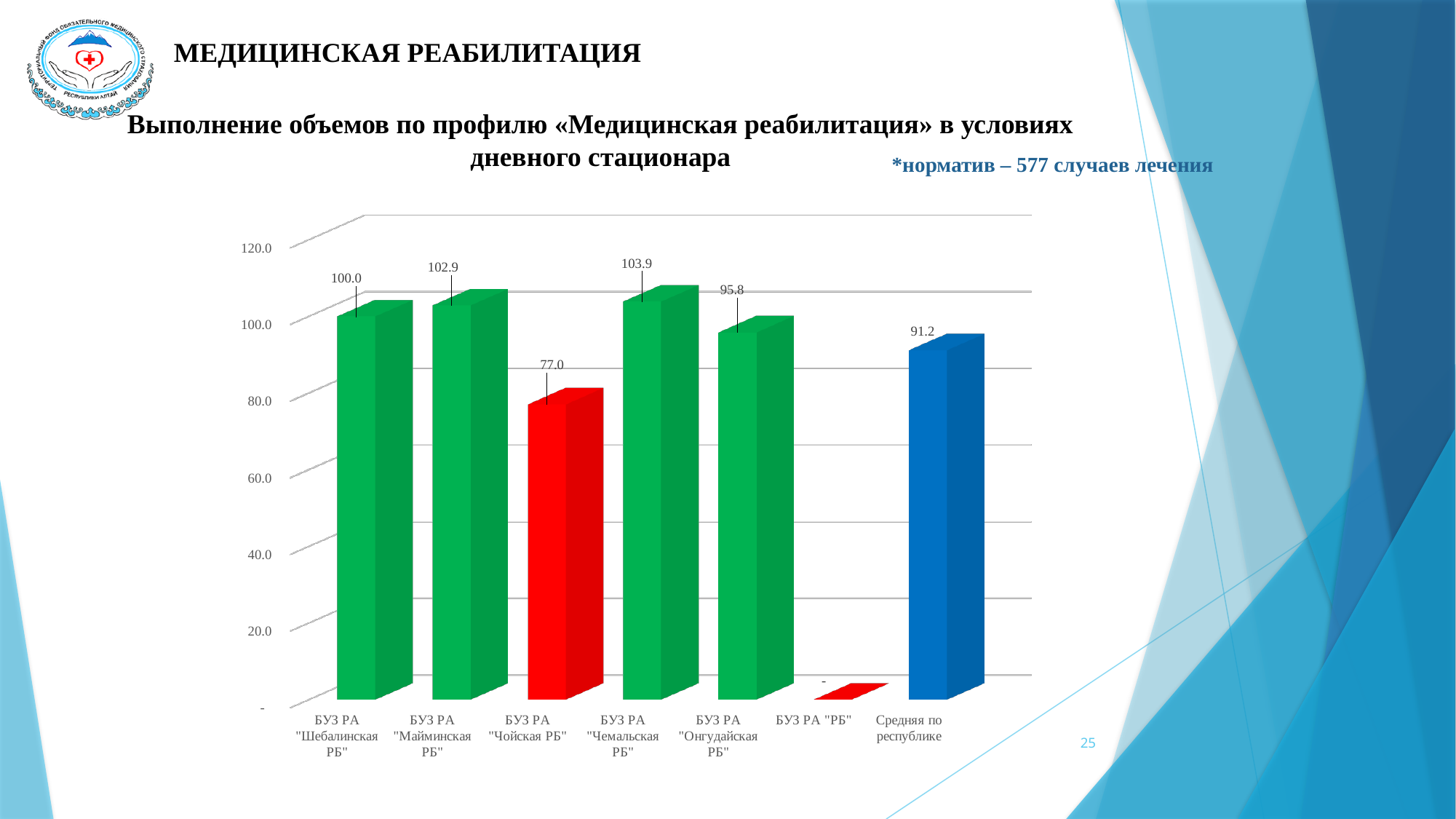
What is the value for БУЗ РА "Онгудайская РБ"? 95.8 Which category has the highest value? БУЗ РА "Чемальская РБ" What is the value for БУЗ РА "Шебалинская РБ"? 100.0 What is the difference between the values for БУЗ РА "Чемальская РБ" and БУЗ РА "Чойская РБ"? 26.9 Which is larger, the value for БУЗ РА "Онгудайская РБ" or the value for Средняя по республике? БУЗ РА "Онгудайская РБ" What is the value for Средняя по республике? 91.2 Which category has the lowest value? БУЗ РА "РБ" How many categories are shown on the x axis? 7 What is the difference between the values for БУЗ РА "Майминская РБ" and БУЗ РА "Шебалинская РБ"? 2.9 Is the value for БУЗ РА "Чойская РБ" greater or less than 80.0? less What is the value for БУЗ РА "Чойская РБ"? 77.0 What kind of chart is shown on the slide? bar chart